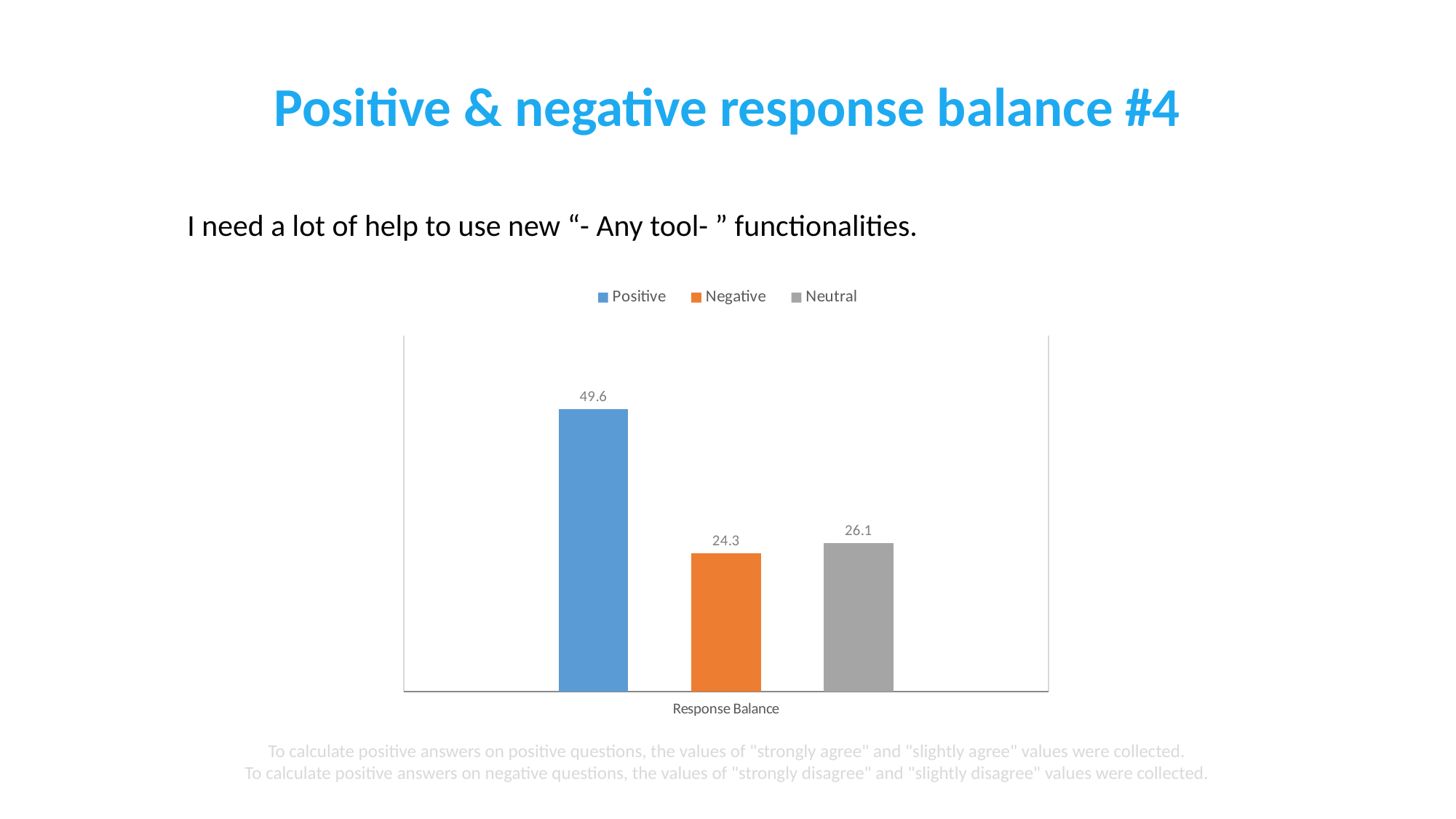
What kind of chart is shown on the slide? Bar chart What is the value of the Neutral bar? 26.1 How many series does the legend list? 3 What colour is the Negative bar? Orange Which is larger, the Positive value or the Neutral value? Positive Which series has the lowest value? Negative What is the difference between the Neutral and Negative values? 1.8 What is the value of the Positive bar? 49.6 What is the difference between the Positive and Negative values? 25.3 Which series has the highest value? Positive What is the value of the Negative bar? 24.3 What is the label on the x axis under the bars? Response Balance